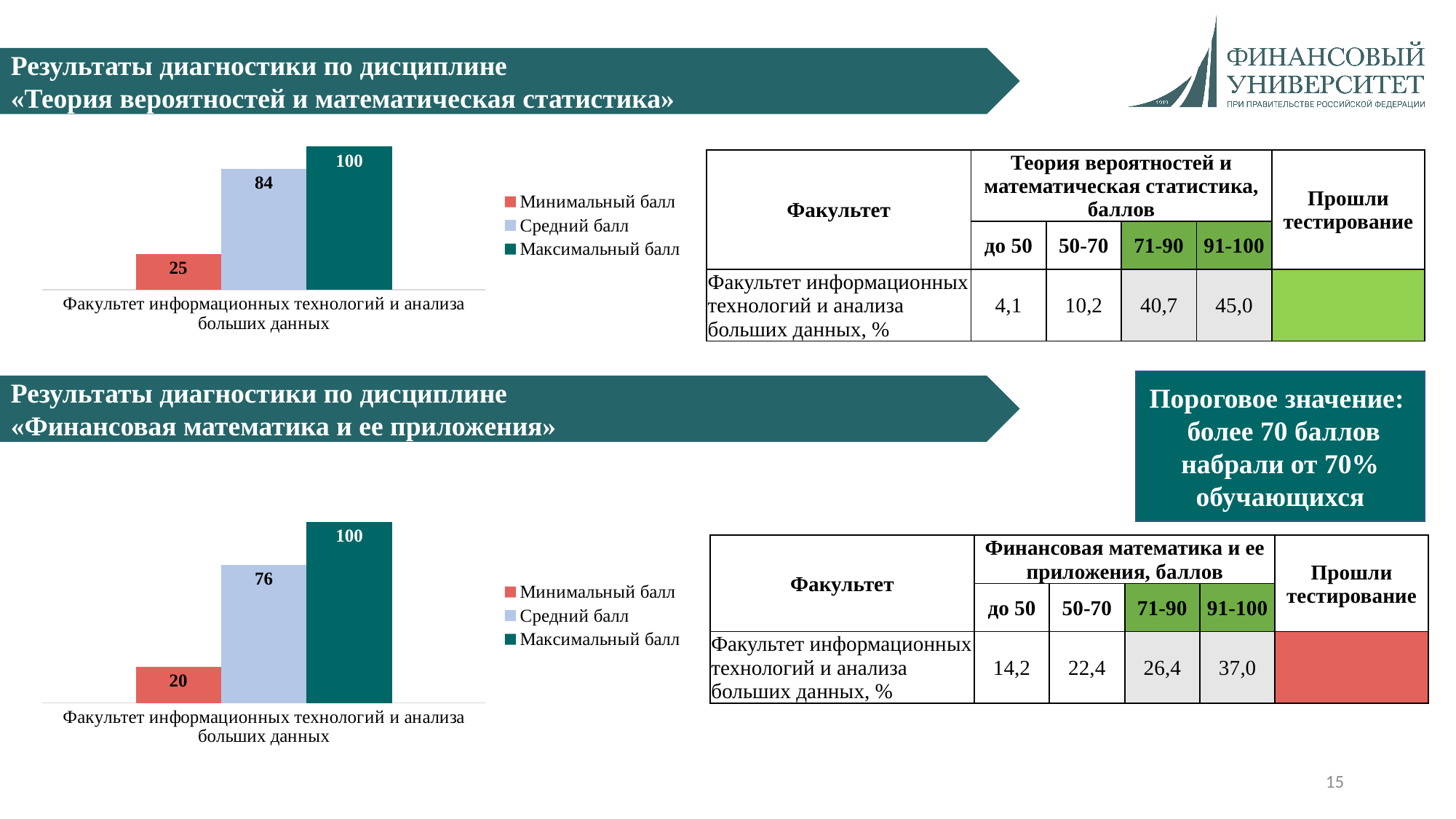
In the bottom chart (Финансовая математика и ее приложения), what is the value of Средний балл? 76 What category is shown on the x axis of the bottom chart? Факультет информационных технологий и анализа больших данных What type of chart is the top chart? Bar chart In the top chart, which series has the highest value? Максимальный балл In the bottom chart, which series has the lowest value? Минимальный балл In the top chart (Теория вероятностей и математическая статистика), what is the value of Средний балл? 84 In the bottom chart (Финансовая математика и ее приложения), what is the value of Минимальный балл? 20 In the bottom chart, what is the difference between Средний балл and Минимальный балл? 56 In the top chart, what is the difference between Максимальный балл and Средний балл? 16 Which is larger: Средний балл in the top chart or Средний балл in the bottom chart? Top chart (84) In the top chart (Теория вероятностей и математическая статистика), what is the value of Минимальный балл? 25 How many series does the legend of the bottom chart list? 3